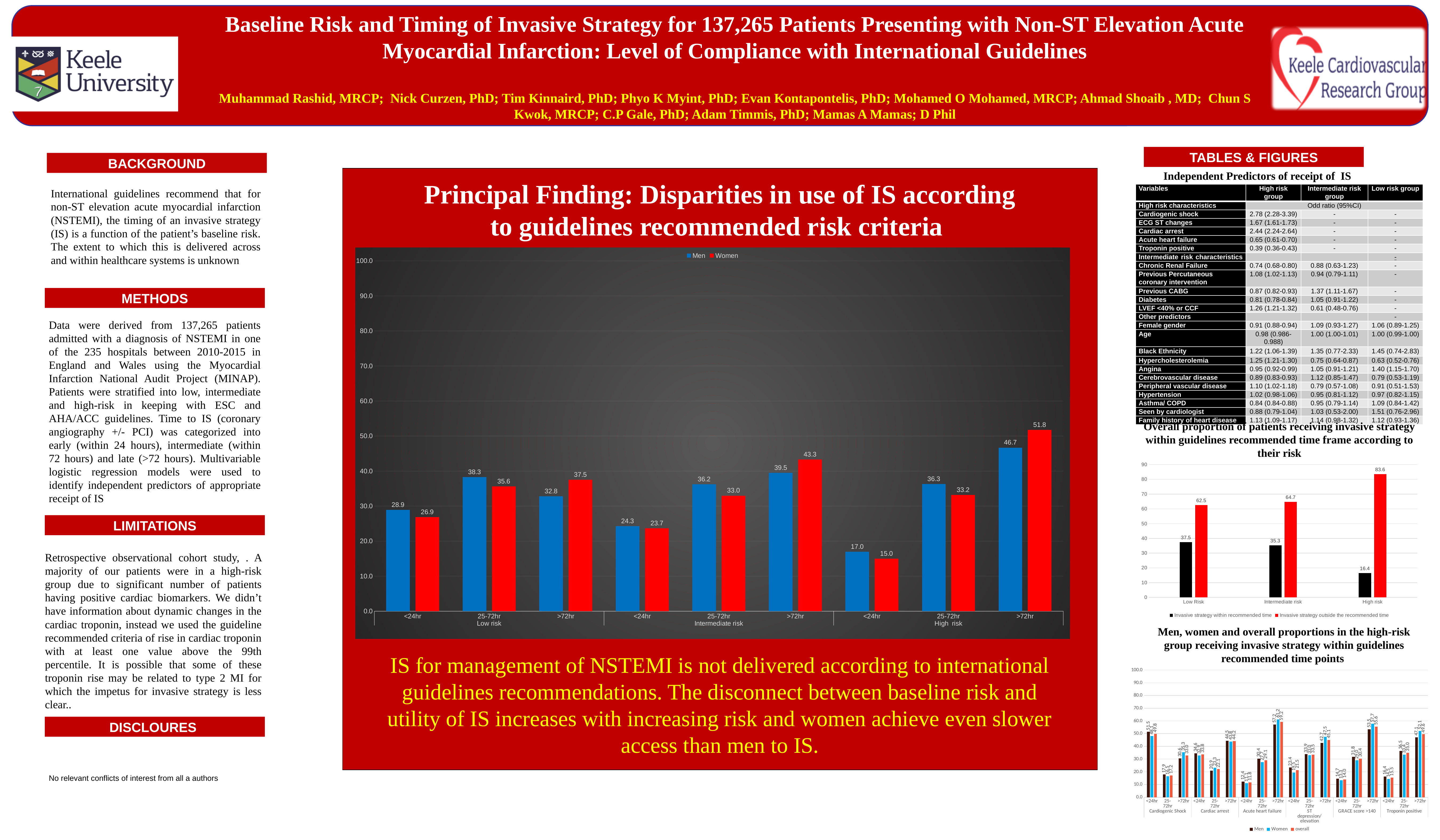
In the Principal Finding chart, which bar has the lowest value? Women, <24hr, High risk In the chart titled 'Overall proportion of patients receiving invasive strategy within guidelines recommended time frame according to their risk', what is the value for invasive strategy within recommended time in the Low Risk group? 37.5 In the Principal Finding chart, what is the value for Men in the <24hr category of the Low risk group? 28.9 In the Principal Finding chart, in the 25-72hr category of the Low risk group, which is larger, Men or Women? Men In the Principal Finding chart, what is the difference between Men and Women in the >72hr category of the High risk group? 5.1 In the chart titled 'Overall proportion of patients receiving invasive strategy within guidelines recommended time frame according to their risk', how do the values for invasive strategy within recommended time change from Low Risk to High risk? They fall How many series does the legend of the Principal Finding chart list? 2 In the Principal Finding chart, what is the value for Women in the 25-72hr category of the Intermediate risk group? 33.0 In the Principal Finding chart, what is the value for Women in the >72hr category of the High risk group? 51.8 In the chart titled 'Overall proportion of patients receiving invasive strategy within guidelines recommended time frame according to their risk', what is the value for invasive strategy outside the recommended time in the High risk group? 83.6 What kind of chart is the Principal Finding chart? Bar chart In the Principal Finding chart, which bar has the highest value? Women, >72hr, High risk